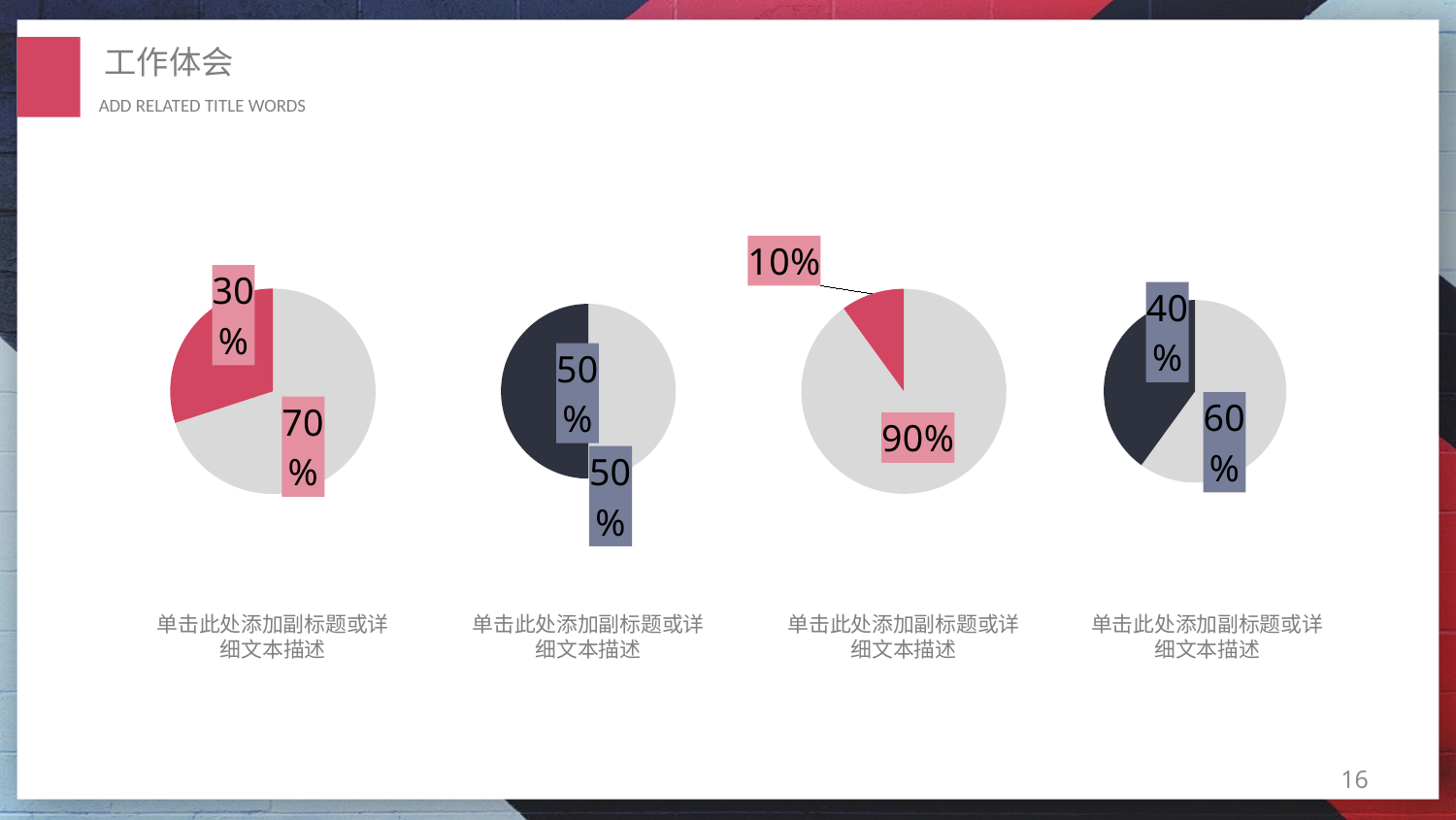
How many slices does the third pie chart from the left have? 2 In the rightmost pie chart, what share does the grey slice represent? 60% What kind of chart is the leftmost chart on the slide? pie chart In the leftmost pie chart, what share does the red slice represent? 30% In the leftmost pie chart, which slice is larger, the red slice or the grey slice? the grey slice In the leftmost pie chart, what share does the grey slice represent? 70% How many pie charts are shown on the slide? 4 In the third pie chart from the left, which slice is the largest? the grey slice (90%) In the rightmost pie chart, what is the difference between the grey slice and the dark slice? 20%